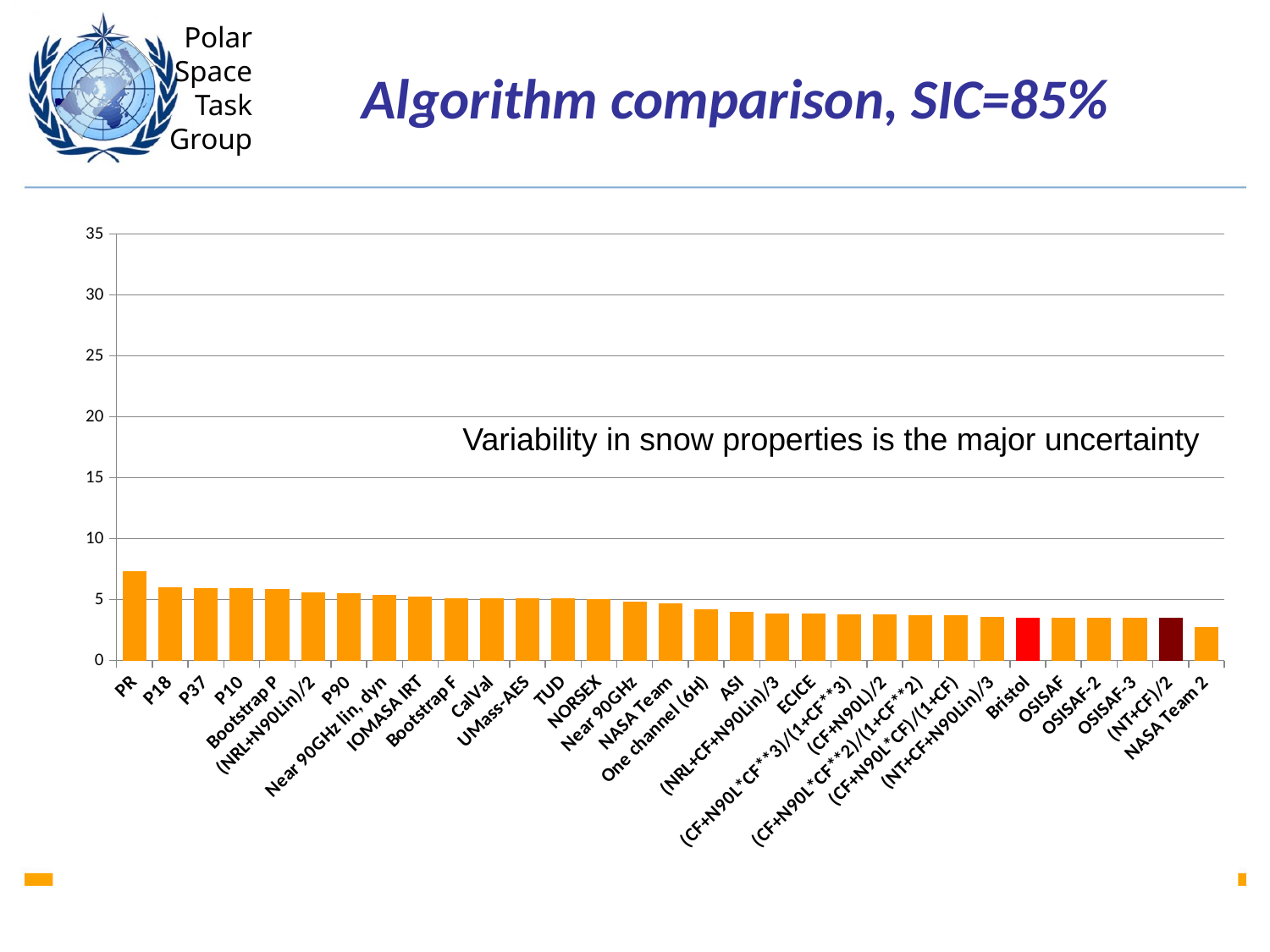
Do the bar values generally rise or fall from left to right along the x axis? fall Which is larger, the value for NASA Team 2 or the value for P37? P37 Is the value for PR greater or less than 5? greater Is the value for Bristol greater or less than 5? less Which algorithm's bar is coloured bright red instead of orange? Bristol Is the value for P18 greater or less than 10? less Which is larger, the value for PR or the value for OSISAF? PR What kind of chart is shown on the slide? bar chart Which algorithm has the highest bar? PR How many algorithms (bars) are plotted in the chart? 31 Which algorithm has the lowest bar? NASA Team 2